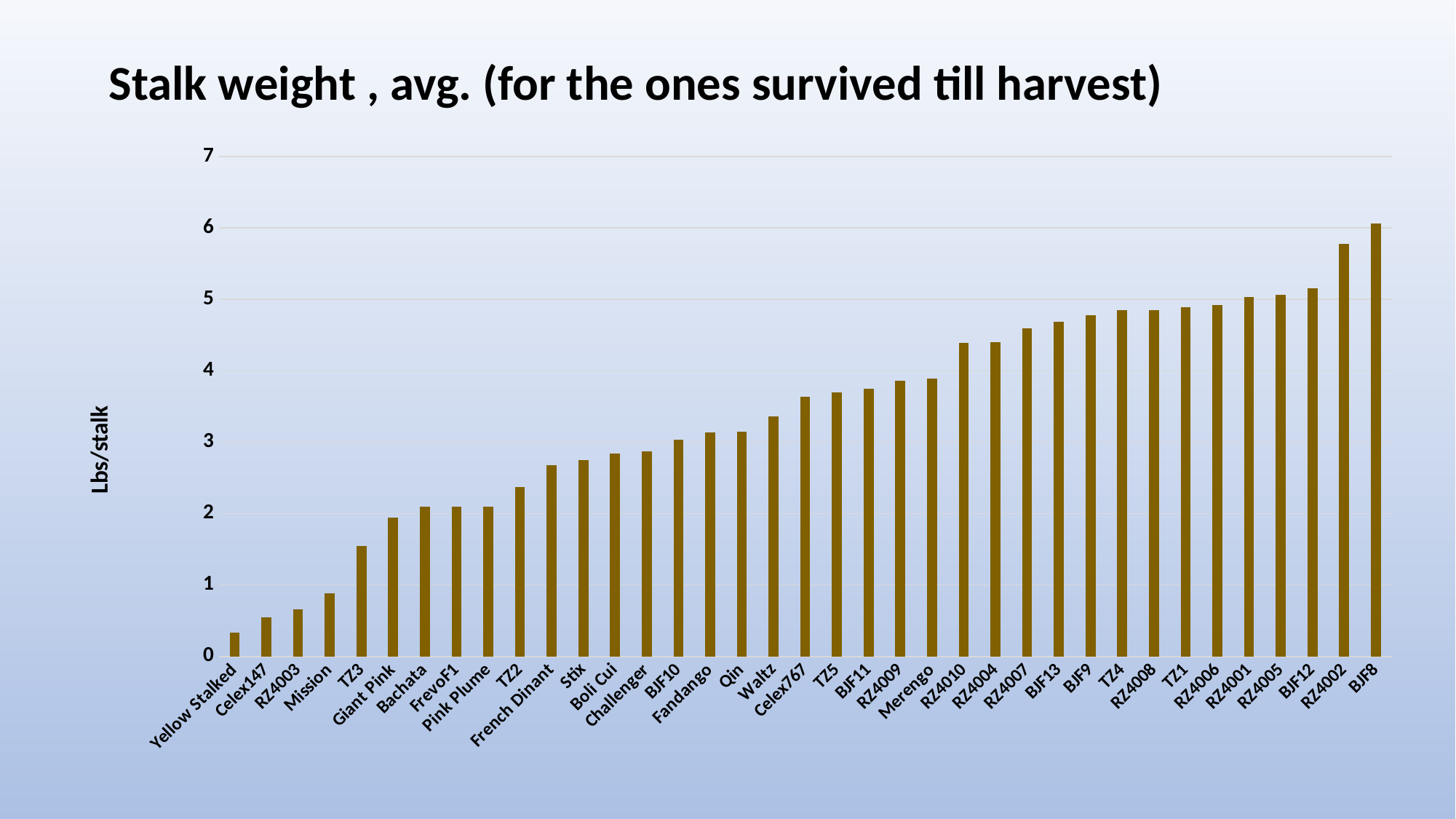
Is the value for RZ4010 greater or less than 4? greater Do the values rise or fall moving from left to right along the x axis? rise How many varieties are plotted on the chart? 37 Which has a higher average stalk weight, Waltz or RZ4010? RZ4010 Which variety has the highest average stalk weight? BJF8 What kind of chart is shown on the slide? bar chart Is the value for Yellow Stalked greater or less than 1? less What is the label on the vertical axis? Lbs/stalk Is the value for RZ4002 greater or less than 5? greater Which variety has the lowest average stalk weight? Yellow Stalked